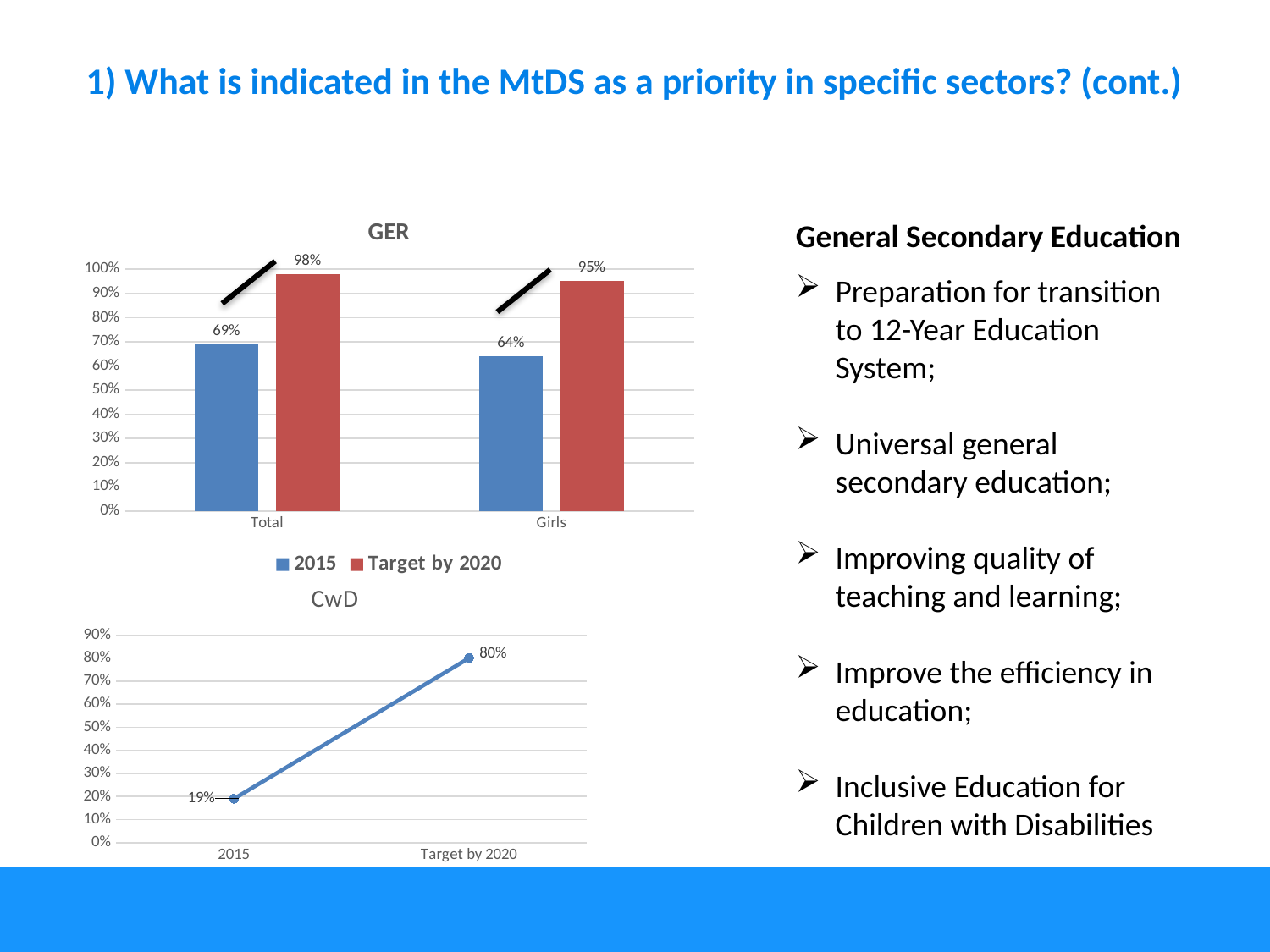
In the GER chart, how many categories are shown on the x axis? 2 In the CwD chart, what is the value for 2015? 19% In the CwD chart, does the value rise or fall from 2015 to Target by 2020? Rise What kind of chart is the CwD chart? Line chart What kind of chart is the GER chart? Bar chart In the GER chart, what is the difference between the Target by 2020 and 2015 values for Girls? 31% In the GER chart, what is the 2015 value for Total? 69% In the GER chart, how many series does the legend list? 2 In the CwD chart, what is the value for Target by 2020? 80% In the GER chart, which category has the lower 2015 value, Total or Girls? Girls In the GER chart, what is the Target by 2020 value for Total? 98% In the GER chart, what is the Target by 2020 value for Girls? 95%